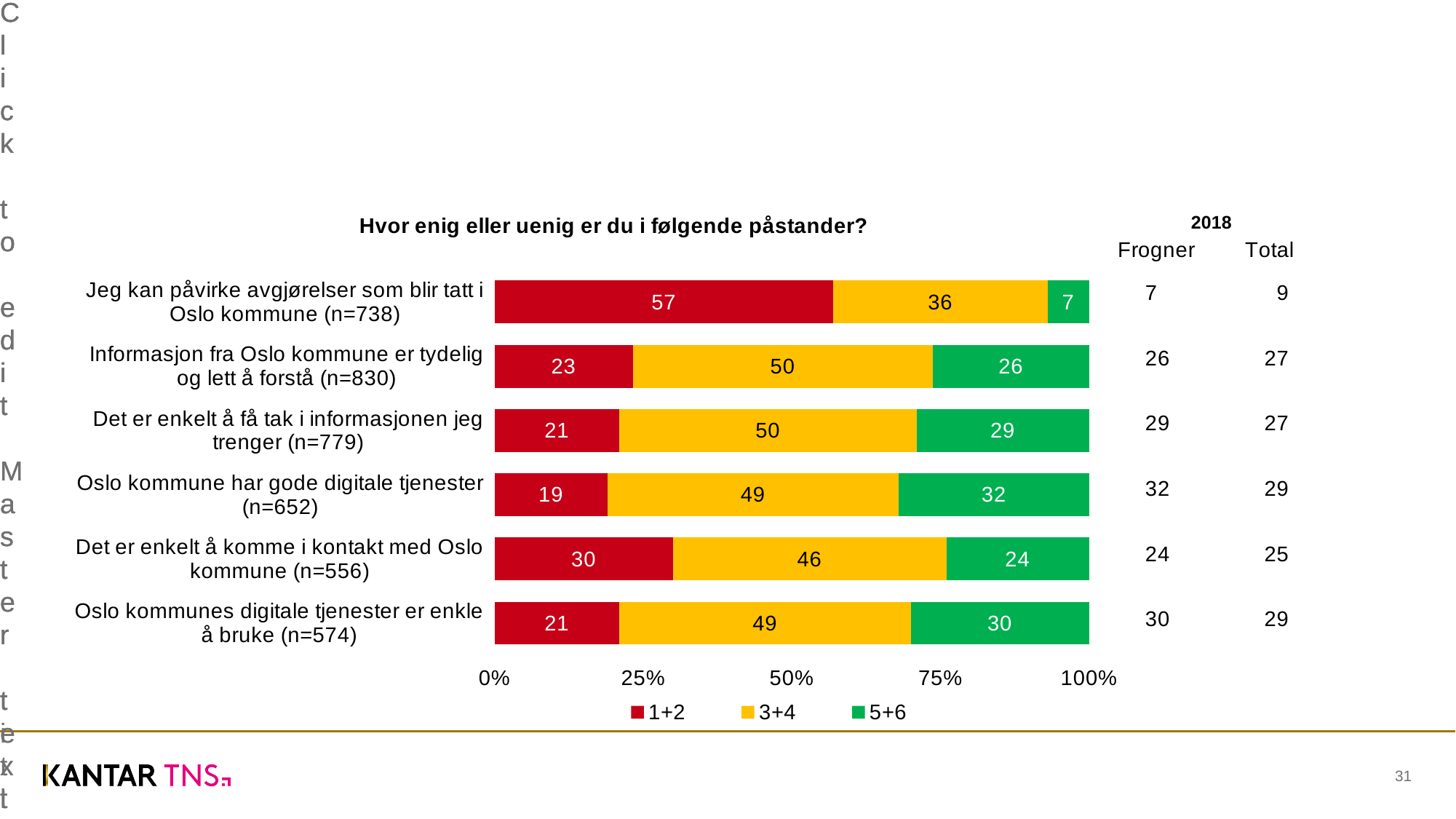
What is the value of the 3+4 series for "Det er enkelt å komme i kontakt med Oslo kommune (n=556)"? 46 What is the total of the stacked bar for "Oslo kommune har gode digitale tjenester (n=652)"? 100 Which statement has the lowest value for the 5+6 series? Jeg kan påvirke avgjørelser som blir tatt i Oslo kommune (n=738) What is the title of the chart? Hvor enig eller uenig er du i følgende påstander? How many statements (categories) are shown in the chart? 6 Which statement has the highest value for the 1+2 series? Jeg kan påvirke avgjørelser som blir tatt i Oslo kommune (n=738) What kind of chart is shown on the slide? Stacked bar chart How many series does the legend list? 3 What is the difference between the 3+4 value for "Informasjon fra Oslo kommune er tydelig og lett å forstå (n=830)" and the 3+4 value for "Det er enkelt å komme i kontakt med Oslo kommune (n=556)"? 4 Which has the larger 5+6 value: "Det er enkelt å få tak i informasjonen jeg trenger (n=779)" or "Oslo kommunes digitale tjenester er enkle å bruke (n=574)"? Oslo kommunes digitale tjenester er enkle å bruke (n=574) What is the value of the 1+2 series for "Jeg kan påvirke avgjørelser som blir tatt i Oslo kommune (n=738)"? 57 What is the value of the 5+6 series for "Oslo kommune har gode digitale tjenester (n=652)"? 32